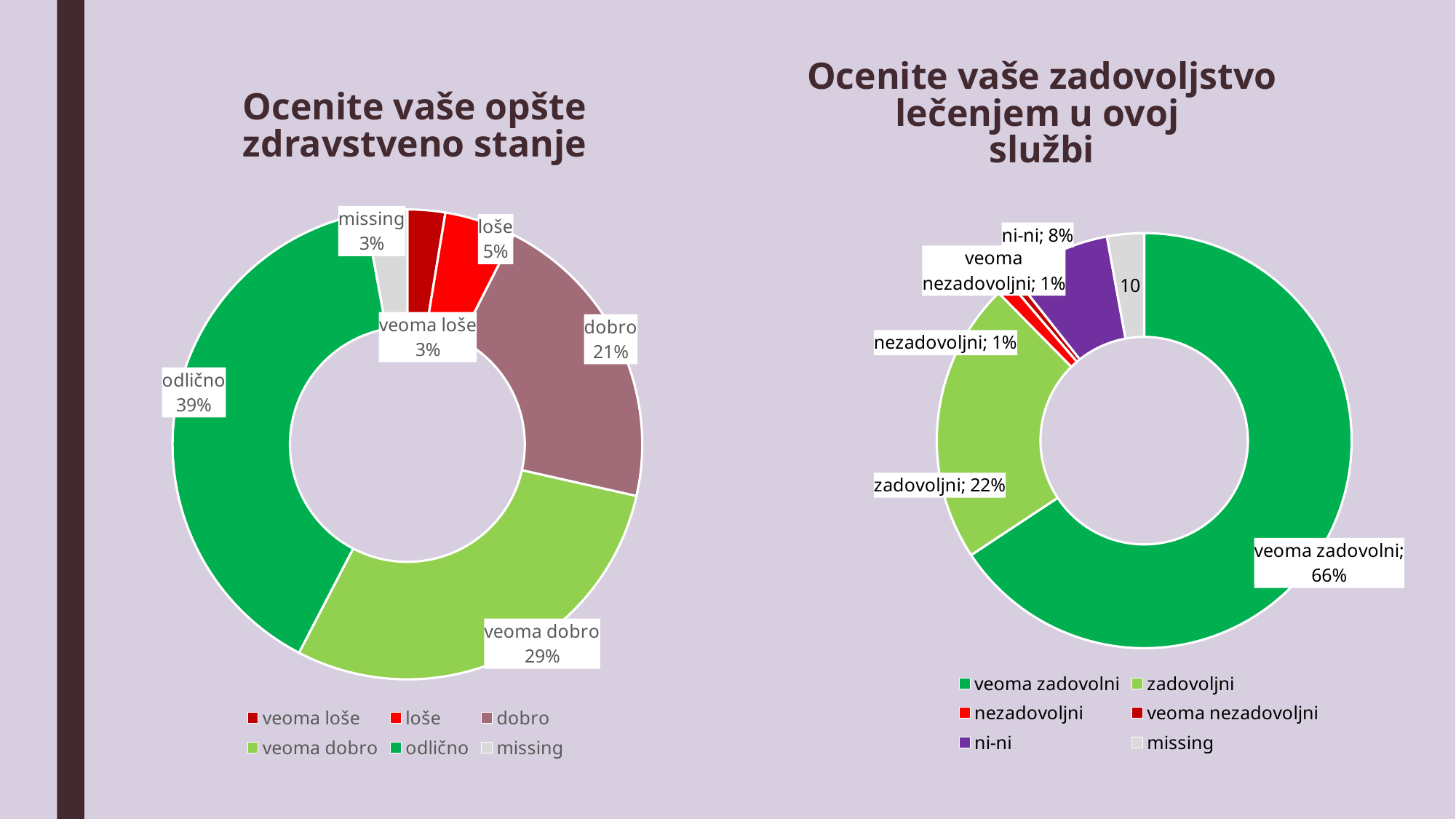
In the right chart 'Ocenite vaše zadovoljstvo lečenjem u ovoj službi', what colour is the 'ni-ni' slice? purple How many categories does the legend of the left chart 'Ocenite vaše opšte zdravstveno stanje' list? 6 In the left chart 'Ocenite vaše opšte zdravstveno stanje', what is the difference between the shares for 'veoma dobro' and 'dobro'? 8% In the left chart 'Ocenite vaše opšte zdravstveno stanje', what share is labelled for 'odlično'? 39% In the right chart 'Ocenite vaše zadovoljstvo lečenjem u ovoj službi', what is the difference between the shares for 'veoma zadovolni' and 'zadovoljni'? 44% In the left chart 'Ocenite vaše opšte zdravstveno stanje', what share is labelled for 'dobro'? 21% In the left chart 'Ocenite vaše opšte zdravstveno stanje', which category has the largest share? odlično In the left chart 'Ocenite vaše opšte zdravstveno stanje', which is larger, the share for 'loše' or the share for 'veoma loše'? loše In the right chart 'Ocenite vaše zadovoljstvo lečenjem u ovoj službi', what share is labelled for 'veoma zadovolni'? 66% In the right chart 'Ocenite vaše zadovoljstvo lečenjem u ovoj službi', what share is labelled for 'zadovoljni'? 22% In the right chart 'Ocenite vaše zadovoljstvo lečenjem u ovoj službi', what share is labelled for 'ni-ni'? 8% What kind of chart is used on the right side of the slide, 'Ocenite vaše zadovoljstvo lečenjem u ovoj službi'? doughnut (pie) chart